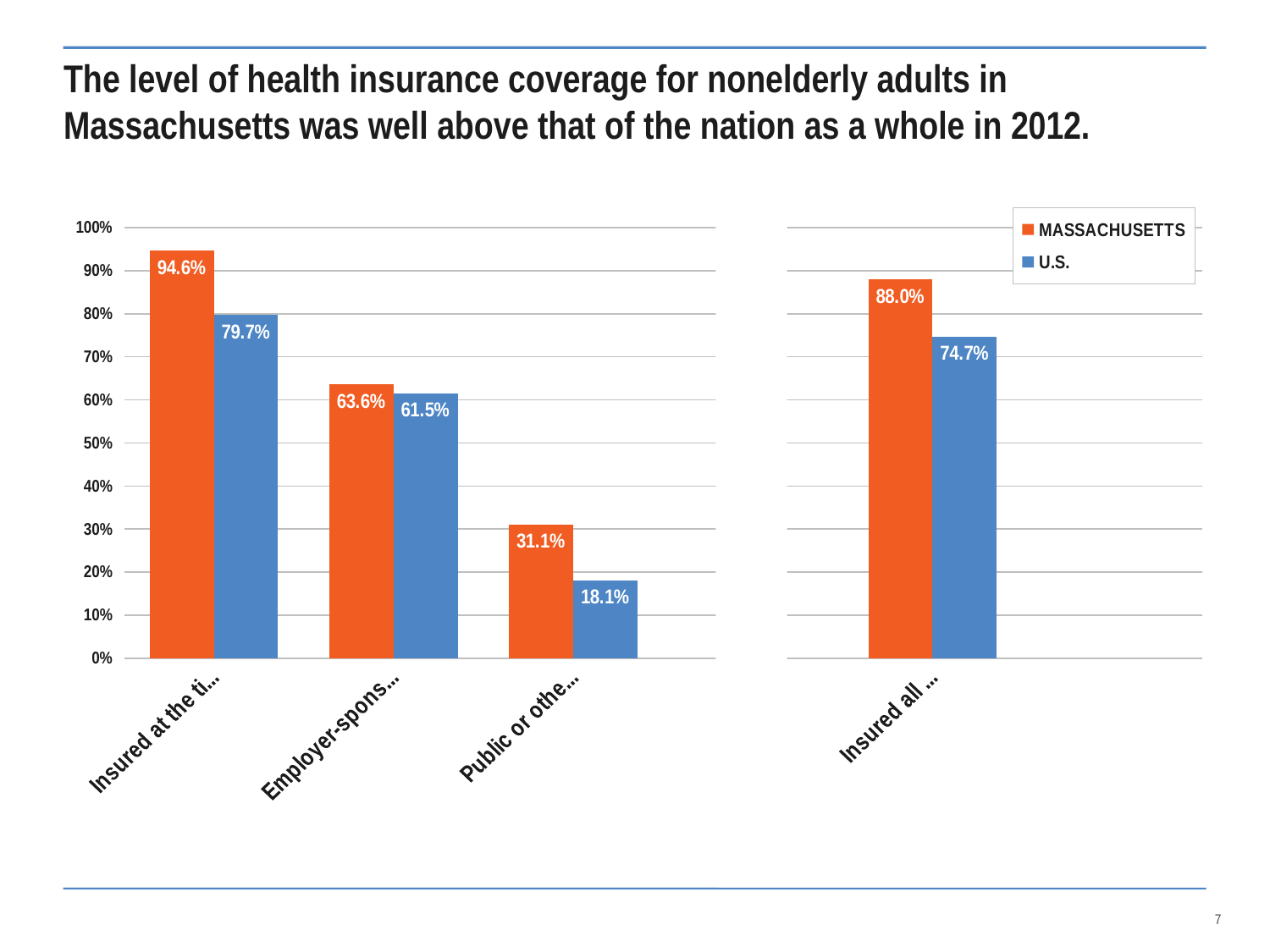
How many series does the legend list? 2 On the left chart, what is the U.S. value for the category labelled 'Employer-spons...'? 61.5% On the left chart, what is the Massachusetts value for the first category (labelled 'Insured at the ti...')? 94.6% On the left chart, what is the U.S. value for the first category (labelled 'Insured at the ti...')? 79.7% On the left chart, what is the difference between the Massachusetts and U.S. values for the category labelled 'Public or othe...'? 13.0% What kind of chart is shown on the left of the slide? Bar chart On the right chart, what is the U.S. value for the category labelled 'Insured all ...'? 74.7% On the left chart, which category has the lowest U.S. value? Public or othe... On the left chart, what is the Massachusetts value for the category labelled 'Public or othe...'? 31.1% On the right chart, what is the Massachusetts value for the category labelled 'Insured all ...'? 88.0% On the right chart, how much higher is the Massachusetts value than the U.S. value? 13.3% On the left chart, is the Massachusetts value or the U.S. value larger for the category labelled 'Employer-spons...'? Massachusetts